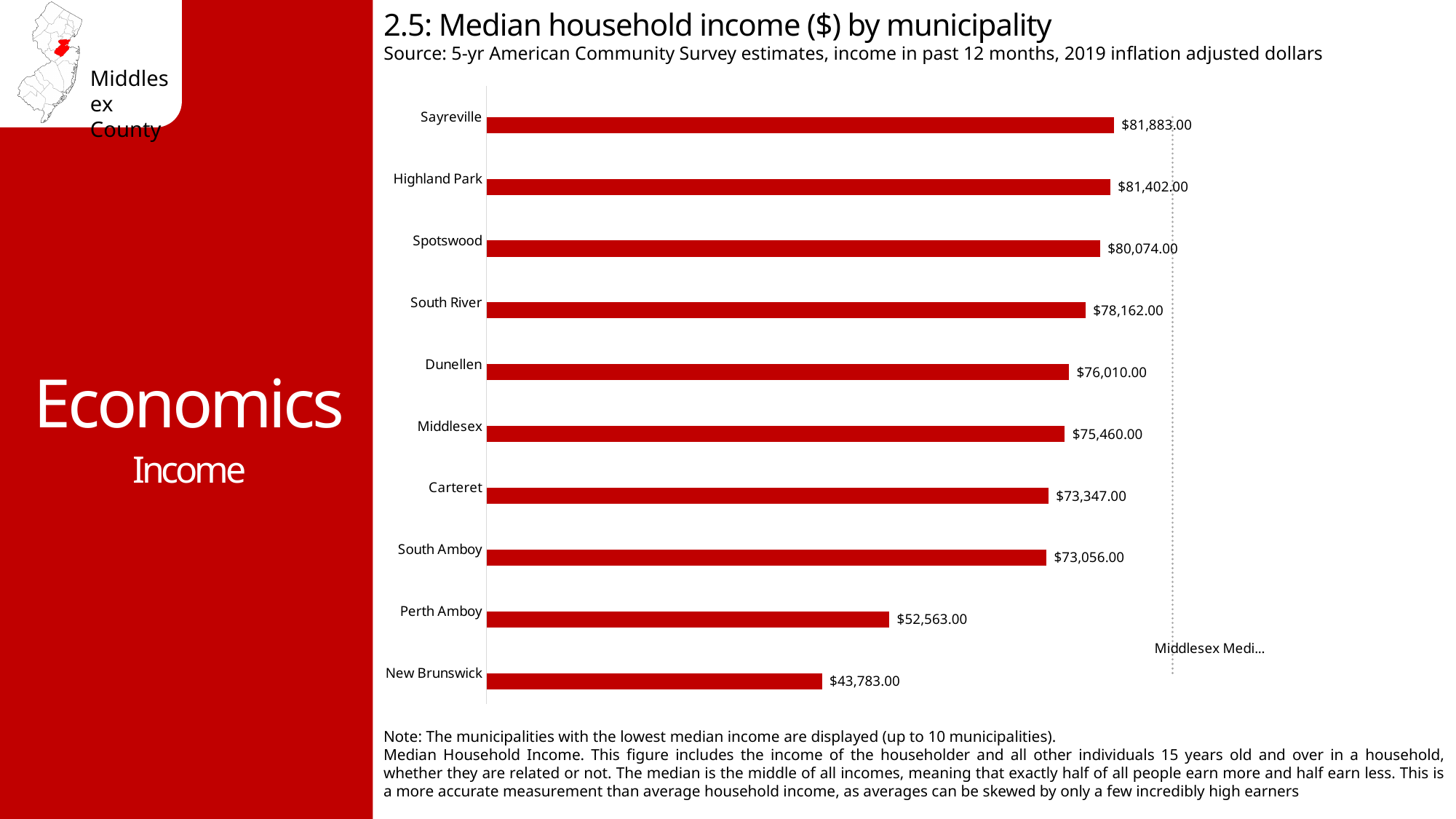
What is the median household income for Dunellen? $76,010.00 Which municipality has the lowest median household income on the chart? New Brunswick What is the median household income for Perth Amboy? $52,563.00 What is the difference between the median household income of Perth Amboy and New Brunswick? $8,780.00 What type of chart is used on this slide? Bar chart Which municipality has the highest median household income on the chart? Sayreville What is the difference between the median household income of Sayreville and New Brunswick? $38,100.00 What is the median household income for New Brunswick? $43,783.00 What is the title of the chart? 2.5: Median household income ($) by municipality What is the median household income for Sayreville? $81,883.00 Which has a higher median household income, Perth Amboy or New Brunswick? Perth Amboy How many municipalities are shown on the chart? 10